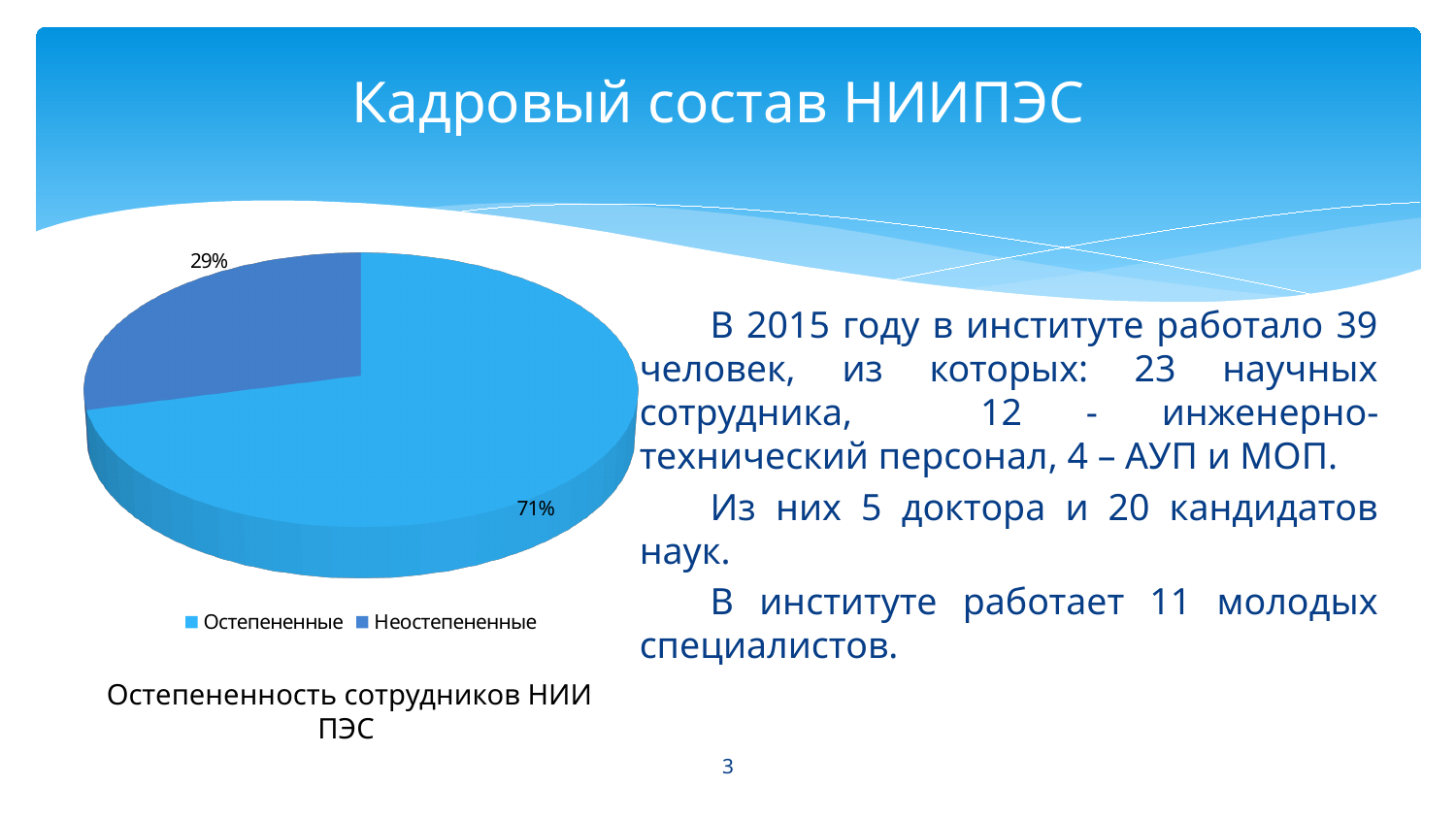
How many entries does the chart legend list? 2 What share of the pie does the "Неостепененные" slice represent? 29% What is the difference in percentage points between the "Остепененные" and "Неостепененные" slices? 42 Which category has the largest slice in the pie chart? Остепененные What is the caption written below the pie chart? Остепененность сотрудников НИИ ПЭС What share of the pie does the "Остепененные" slice represent? 71% Which slice is larger, "Остепененные" or "Неостепененные"? Остепененные What kind of chart is shown on the slide? pie chart How many slices does the pie chart have? 2 Which legend entry is shown in the darker blue colour? Неостепененные Which category has the smallest slice in the pie chart? Неостепененные